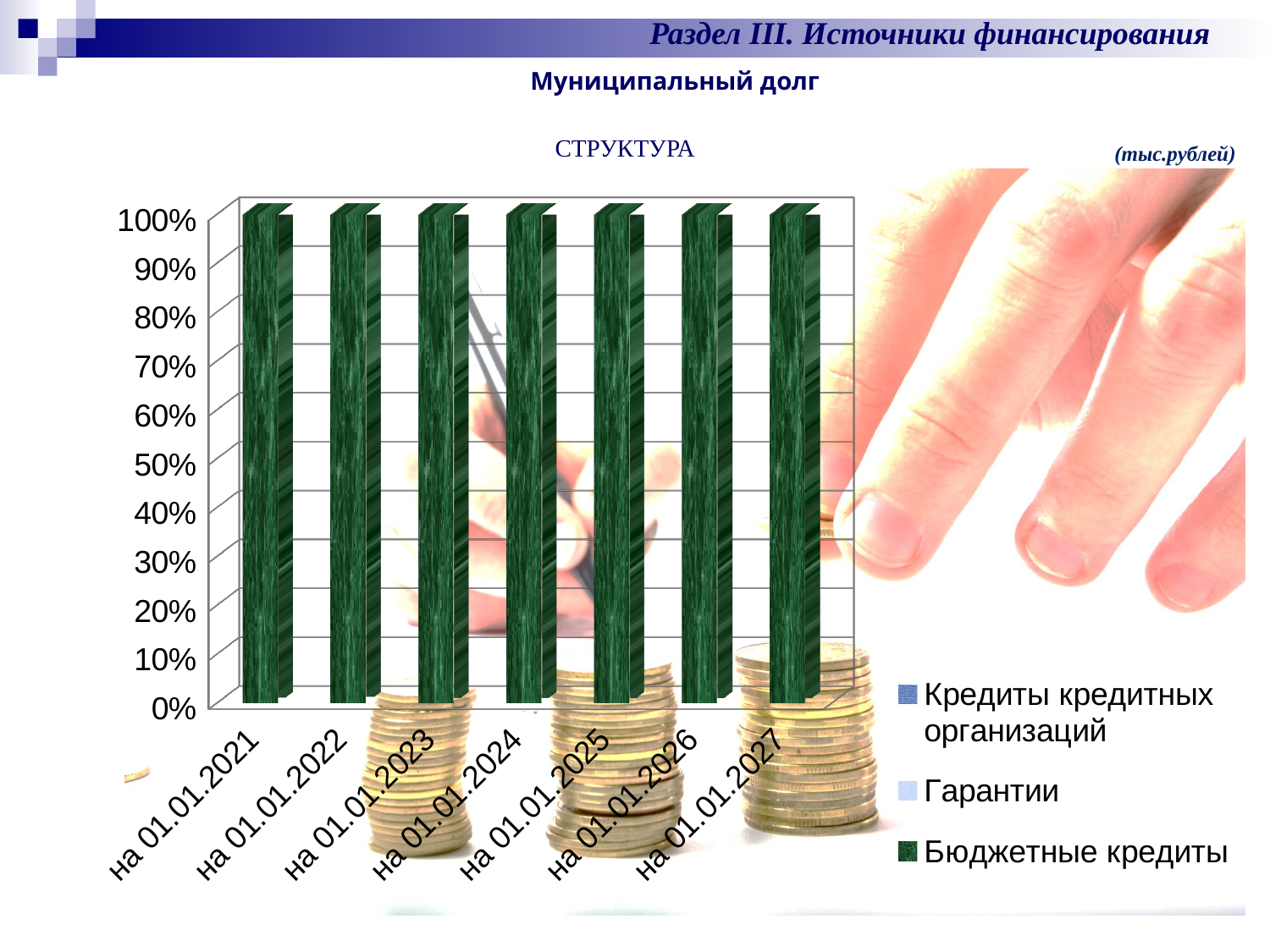
Which series does the dark green colour represent in the legend? Бюджетные кредиты How many series does the chart legend list? 3 What is the title of the chart? СТРУКТУРА What is the last category on the x axis? на 01.01.2027 What is the highest value shown on the y axis? 100% How many categories (dates) are shown on the x axis of the chart? 7 What is the first category on the x axis? на 01.01.2021 What kind of chart is shown on the slide? bar chart What share of the bar for на 01.01.2027 is made up by Бюджетные кредиты? 100% Is the value for Бюджетные кредиты at на 01.01.2024 greater or less than 50%? greater Does the share of Бюджетные кредиты rise, fall, or stay the same from на 01.01.2021 to на 01.01.2027? stays the same What share of the bar for на 01.01.2021 is made up by Бюджетные кредиты? 100%